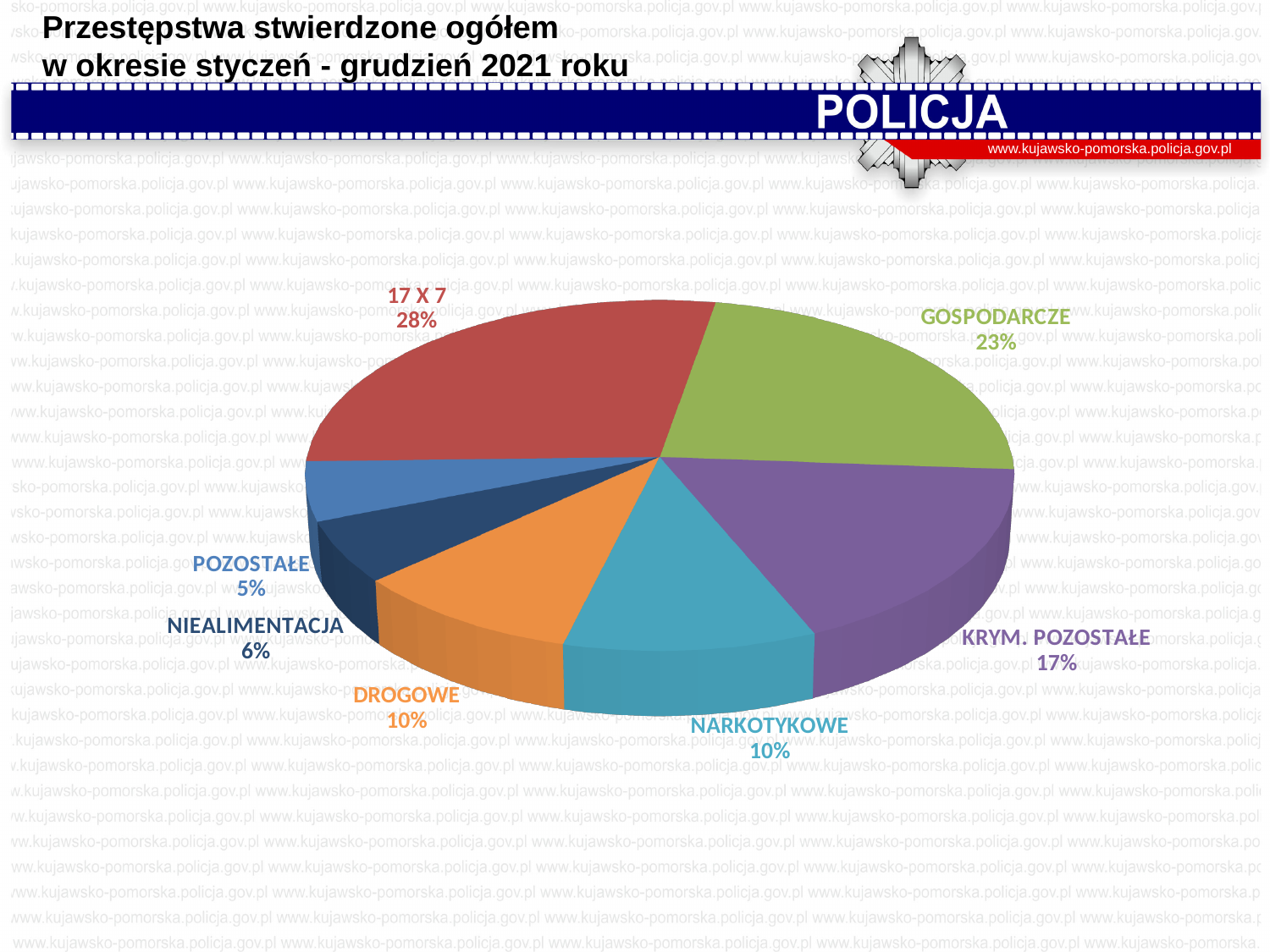
What kind of chart is shown on the slide? pie chart What is the difference in percentage points between the 17 X 7 slice and the GOSPODARCZE slice? 5 Which slice is larger, KRYM. POZOSTAŁE or DROGOWE? KRYM. POZOSTAŁE What share of the pie does the GOSPODARCZE slice have? 23% Which category has the largest slice of the pie? 17 X 7 Which category has the smallest slice of the pie? POZOSTAŁE What share of the pie does the KRYM. POZOSTAŁE slice have? 17% How many slices does the pie chart have? 7 What share of the pie does the 17 X 7 slice have? 28% What is the title of the slide containing the pie chart? Przestępstwa stwierdzone ogółem w okresie styczeń - grudzień 2021 roku